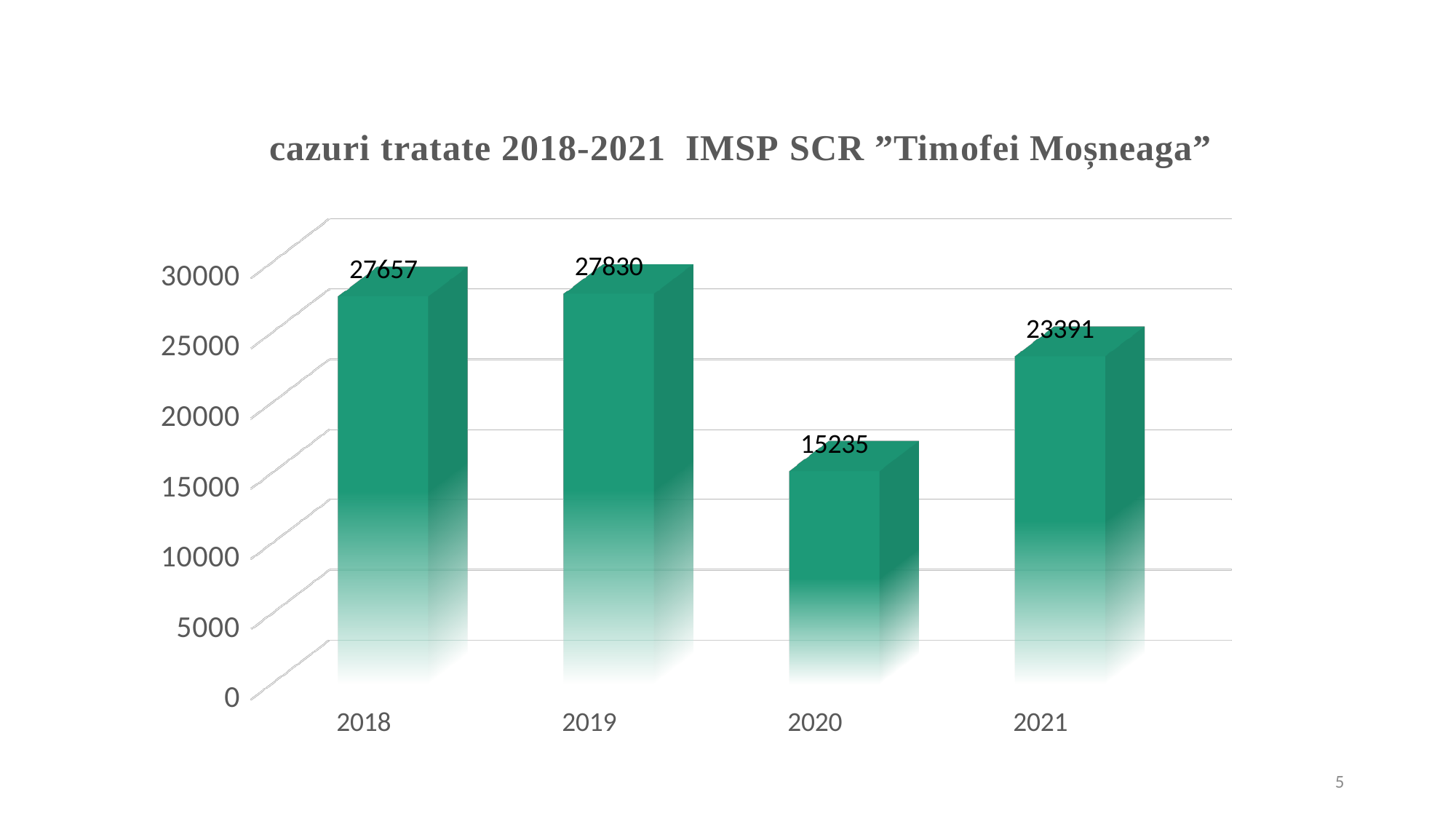
What is the value for 2021? 23391 What is the title of the chart? cazuri tratate 2018-2021 IMSP SCR ”Timofei Moșneaga” What is the value for 2018? 27657 Is the value for 2020 greater or less than 20000? less Which year has the lowest value? 2020 What is the difference between the values for 2019 and 2020? 12595 How many years are shown on the chart? 4 Which is larger, the value for 2018 or the value for 2021? 2018 Which year has the highest value? 2019 What is the value for 2020? 15235 What kind of chart is this? bar chart What is the difference between the values for 2021 and 2020? 8156